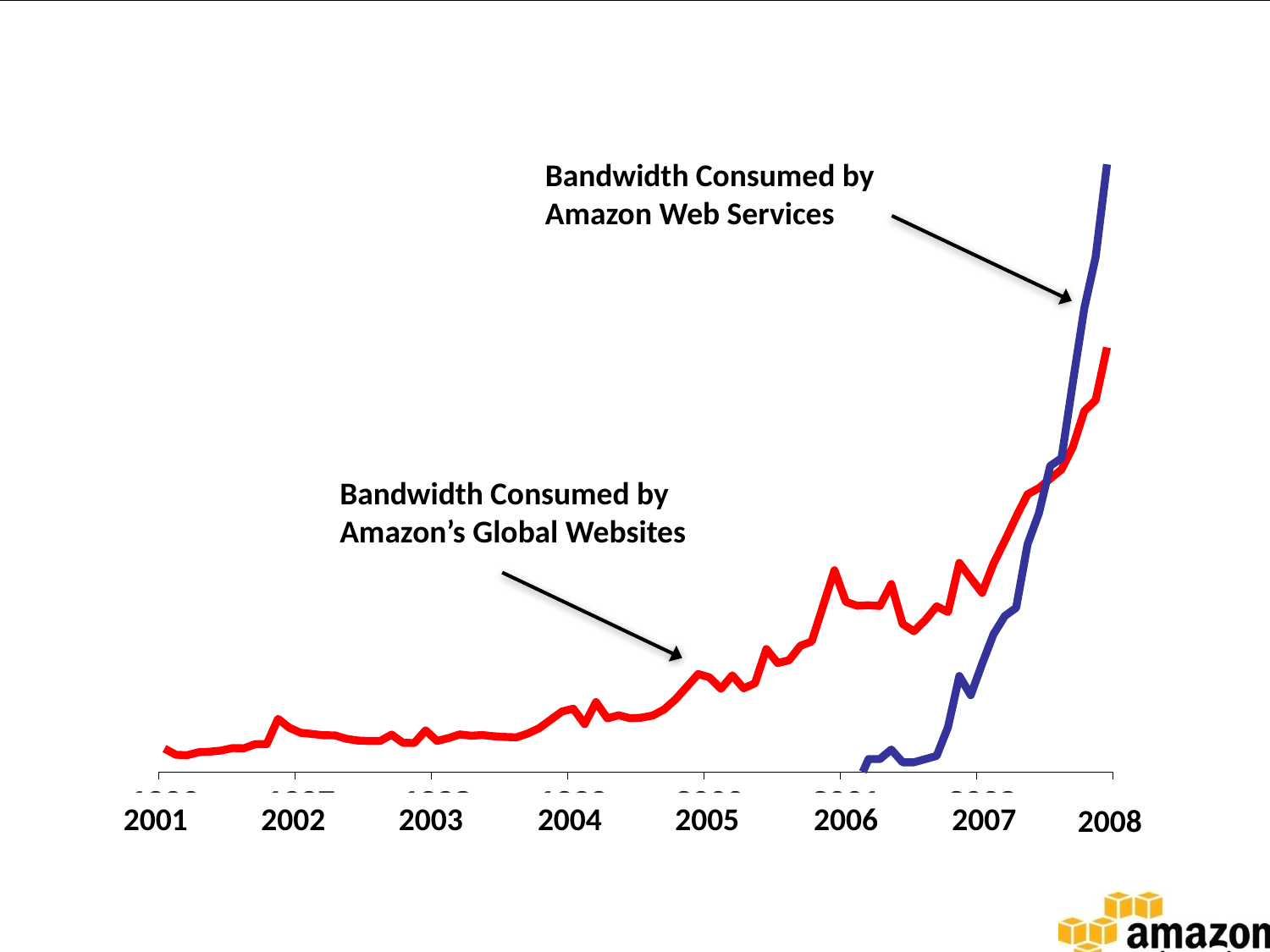
How many data series are plotted on the chart? 2 What is the last year labelled on the x axis? 2008 At 2008, which series is higher: Amazon Web Services or Amazon's Global Websites? Amazon Web Services Which series reaches the highest point on the chart? Bandwidth Consumed by Amazon Web Services Which series is drawn in blue? Bandwidth Consumed by Amazon Web Services What is the first year labelled on the x axis? 2001 Does the bandwidth consumed by Amazon's Global Websites rise or fall from 2001 to 2008? Rise At 2005, which series is higher: Amazon Web Services or Amazon's Global Websites? Amazon's Global Websites Does the bandwidth consumed by Amazon Web Services rise or fall from 2006 to 2008? Rise How many year labels appear along the x axis of the chart? 8 What kind of chart is shown on the slide? Line chart